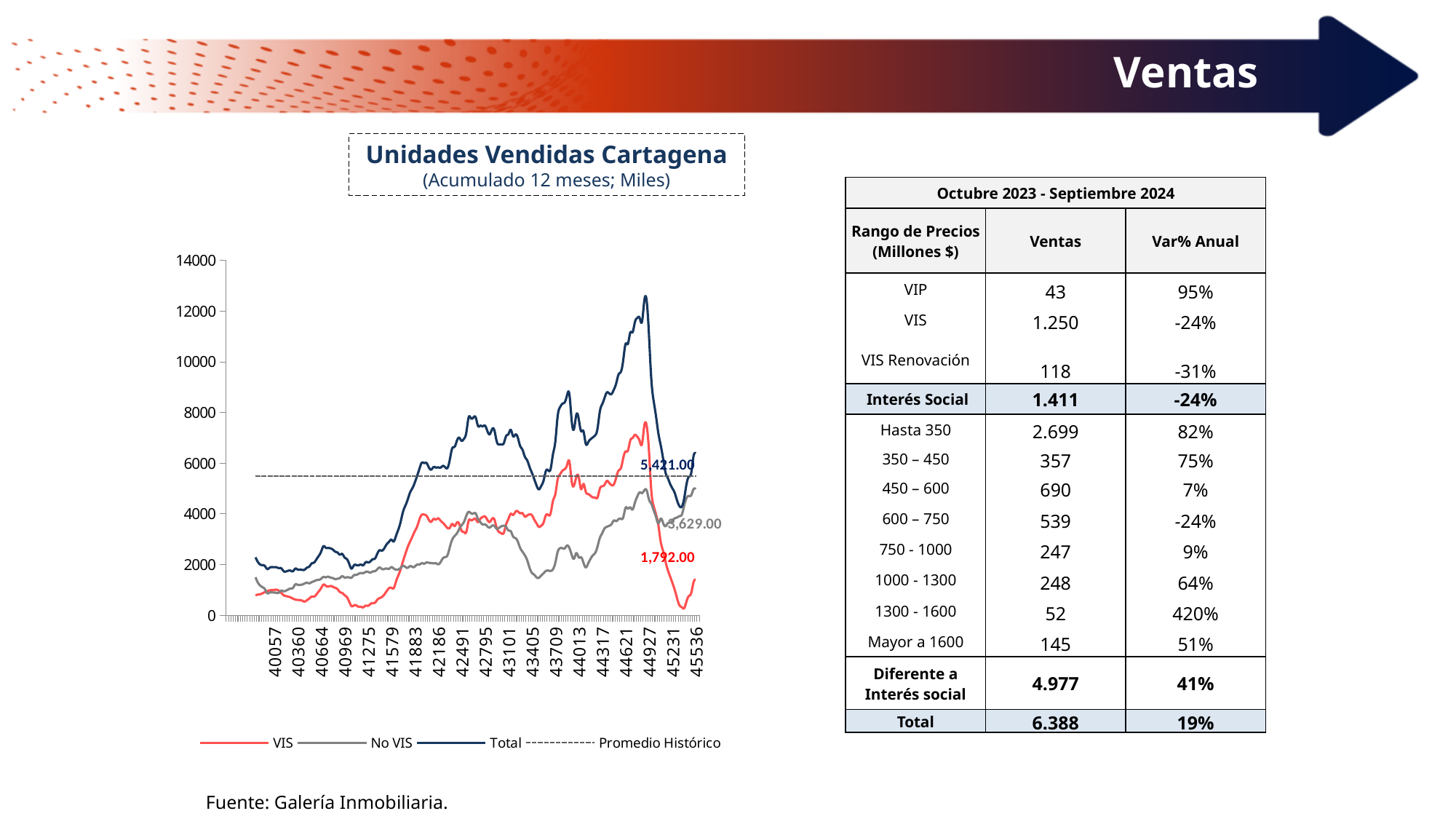
On the 'Unidades Vendidas Cartagena' chart, which labelled value is larger: No VIS or VIS? No VIS What is the labelled value for the Total series at the end of the 'Unidades Vendidas Cartagena' chart? 5,421.00 What is the subtitle shown under the title 'Unidades Vendidas Cartagena'? (Acumulado 12 meses; Miles) Which series reaches the highest value on the 'Unidades Vendidas Cartagena' chart? Total On the 'Unidades Vendidas Cartagena' chart, what is the difference between the labelled Total value (5,421.00) and the labelled VIS value (1,792.00)? 3,629.00 What is the labelled value for the VIS series on the 'Unidades Vendidas Cartagena' chart? 1,792.00 How many series does the legend of the 'Unidades Vendidas Cartagena' chart list? 4 What kind of chart is shown under the title 'Unidades Vendidas Cartagena'? line chart On the 'Unidades Vendidas Cartagena' chart, does the Total series rise or fall between its peak near 44927 and 45231? fall On the 'Unidades Vendidas Cartagena' chart, is the peak of the Total series greater or less than 10000? greater On the 'Unidades Vendidas Cartagena' chart, is the Promedio Histórico dashed line greater or less than 6000? less What is the labelled value for the No VIS series on the 'Unidades Vendidas Cartagena' chart? 3,629.00